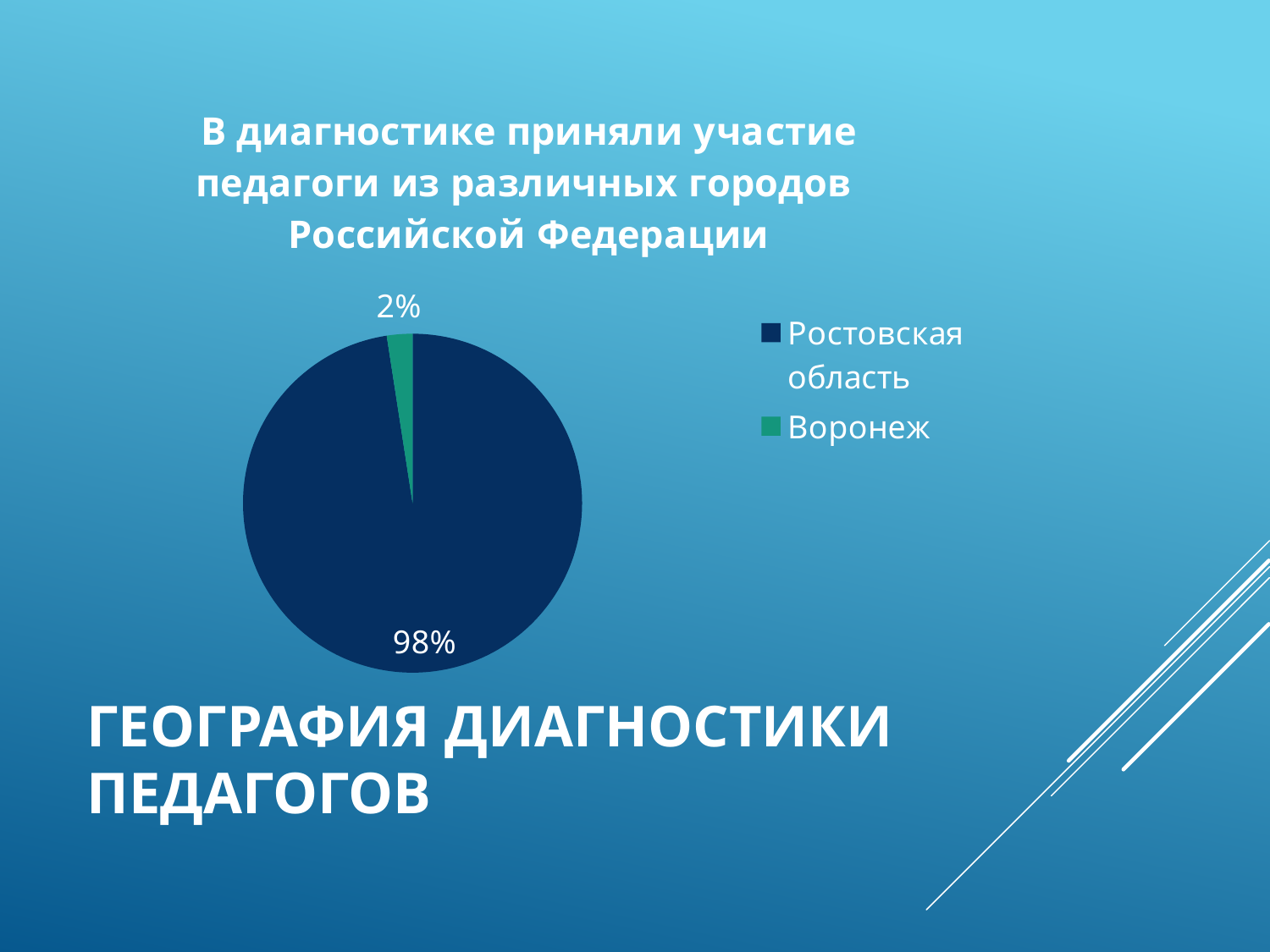
Which is larger, the slice for Ростовская область or the slice for Воронеж? Ростовская область How many categories does the pie chart show? 2 What share of the pie does Воронеж have? 2% What share of the pie does Ростовская область have? 98% Which category has the smallest slice of the pie? Воронеж How many entries does the legend list? 2 Which category has the largest slice of the pie? Ростовская область What is the difference in percentage points between the Ростовская область slice and the Воронеж slice? 96 Which category is shown in green in the pie chart? Воронеж What kind of chart is shown on the slide? pie chart What is the title of the chart? В диагностике приняли участие педагоги из различных городов Российской Федерации